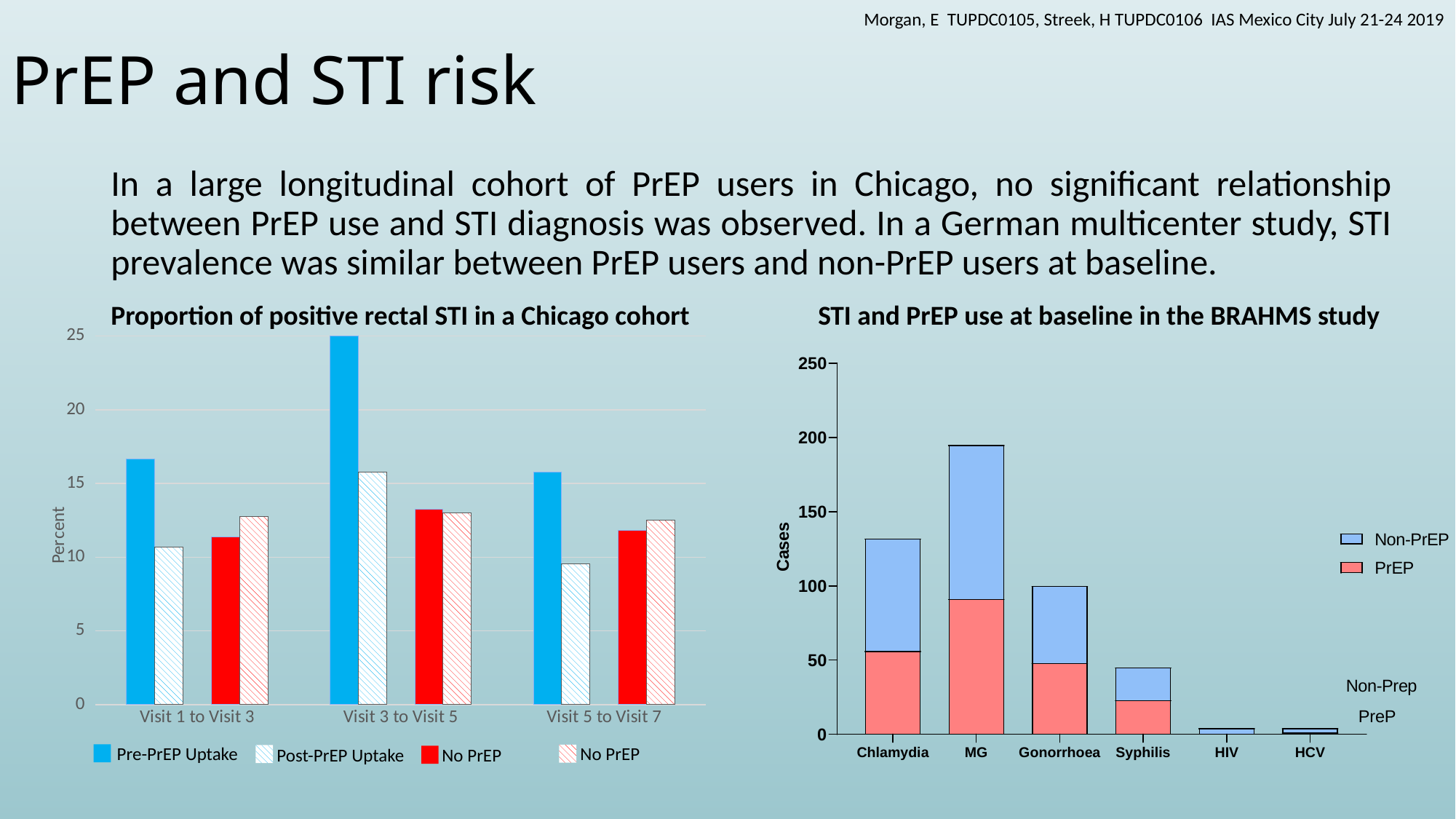
In the 'STI and PrEP use at baseline in the BRAHMS study' chart, is the total number of cases for Syphilis greater or less than 50? less In the 'Proportion of positive rectal STI in a Chicago cohort' chart, how many visit-interval categories are shown on the x axis? 3 In the 'Proportion of positive rectal STI in a Chicago cohort' chart, is the Pre-PrEP Uptake value for Visit 1 to Visit 3 greater or less than 15? greater In the 'STI and PrEP use at baseline in the BRAHMS study' chart, which has the larger total number of cases: Chlamydia or Gonorrhoea? Chlamydia How many series does the legend of the 'STI and PrEP use at baseline in the BRAHMS study' chart list? 2 In the 'STI and PrEP use at baseline in the BRAHMS study' chart, which STI has the highest total number of cases? MG What kind of chart is the 'STI and PrEP use at baseline in the BRAHMS study' chart? stacked bar chart In the 'STI and PrEP use at baseline in the BRAHMS study' chart, how many STI categories are shown on the x axis? 6 What kind of chart is the 'Proportion of positive rectal STI in a Chicago cohort' chart? bar chart In the 'Proportion of positive rectal STI in a Chicago cohort' chart, is the Post-PrEP Uptake value for Visit 5 to Visit 7 greater or less than 10? less In the 'Proportion of positive rectal STI in a Chicago cohort' chart, which visit interval has the highest Pre-PrEP Uptake bar? Visit 3 to Visit 5 In the 'Proportion of positive rectal STI in a Chicago cohort' chart, for Visit 3 to Visit 5, which is larger: Pre-PrEP Uptake or Post-PrEP Uptake? Pre-PrEP Uptake